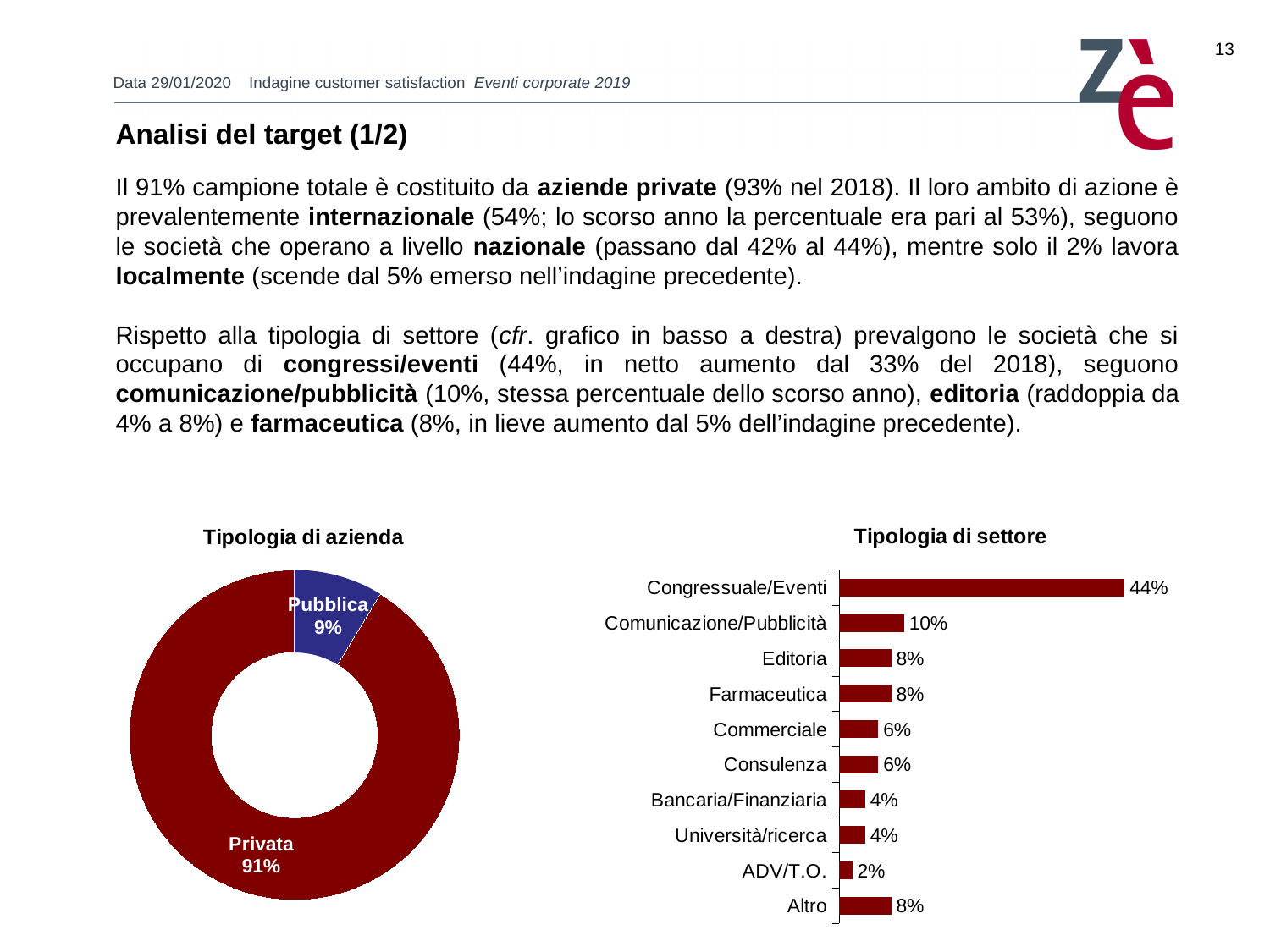
In the 'Tipologia di settore' chart, what is the value for Congressuale/Eventi? 44% In the 'Tipologia di settore' chart, what is the value for Comunicazione/Pubblicità? 10% What kind of chart is 'Tipologia di settore'? Bar chart In the 'Tipologia di settore' chart, what is the value for ADV/T.O.? 2% In the 'Tipologia di settore' chart, which category has the lowest value? ADV/T.O. In the 'Tipologia di azienda' chart, what share is Privata? 91% How many categories are shown in the 'Tipologia di settore' chart? 10 What kind of chart is 'Tipologia di azienda'? Doughnut chart In the 'Tipologia di settore' chart, which is larger, Commerciale or Bancaria/Finanziaria? Commerciale In the 'Tipologia di azienda' chart, what share is Pubblica? 9% In the 'Tipologia di settore' chart, which category has the highest value? Congressuale/Eventi In the 'Tipologia di settore' chart, what is the difference between Congressuale/Eventi and Comunicazione/Pubblicità? 34%